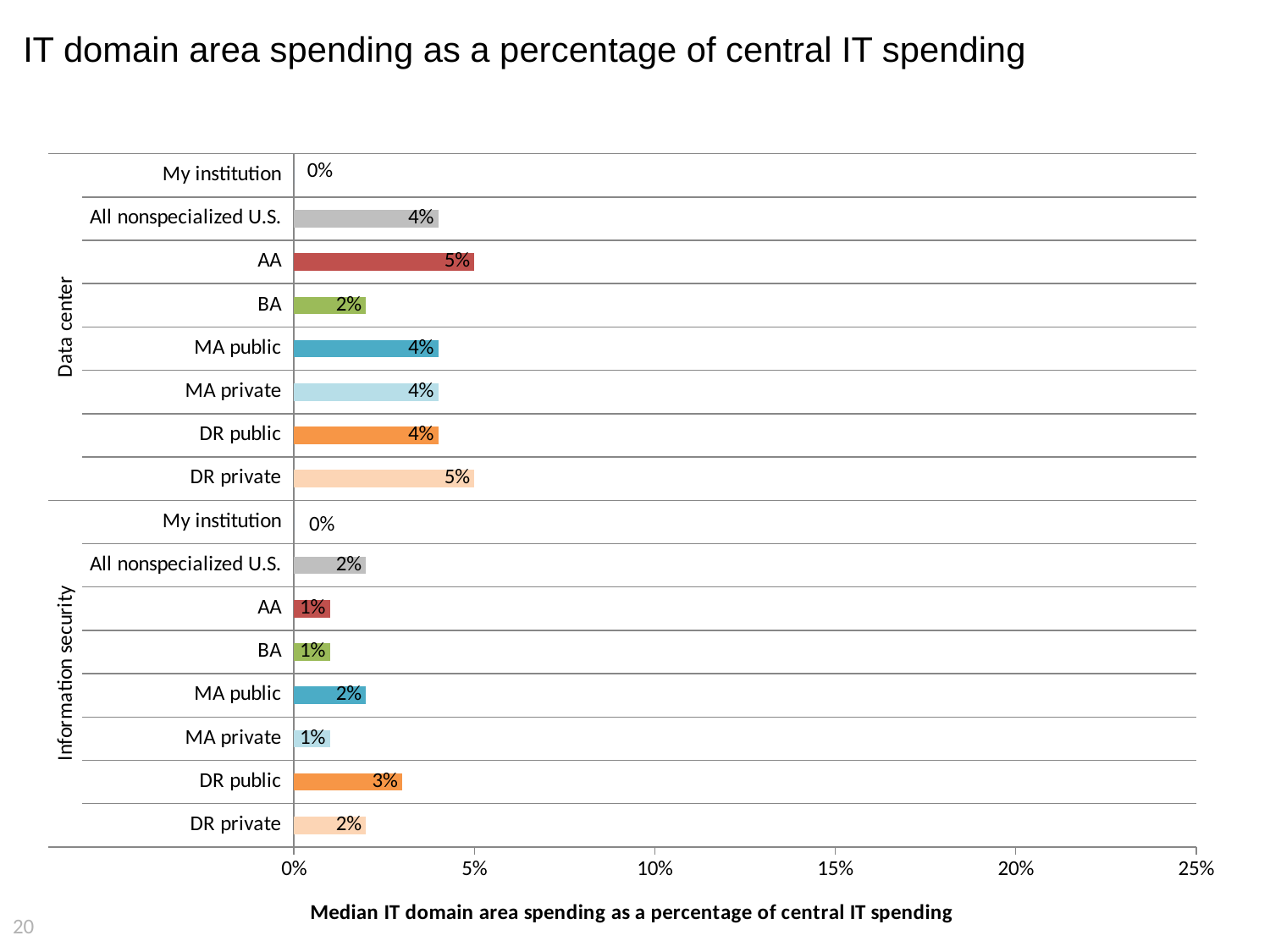
What is the x-axis title of the chart? Median IT domain area spending as a percentage of central IT spending What is the Data center value for AA? 5% What kind of chart is shown on the slide? Bar chart Which category has the lowest value in the Data center group? My institution In the Data center group, which is larger: the value for AA or the value for BA? AA Which category has the highest value in the Information security group? DR public What is the Data center value for BA? 2% Is the Data center value for DR private greater or less than 10%? less How many bars are plotted in the Information security group? 8 What is the difference between the Data center values for AA and BA? 3 percentage points What is the Information security value for DR public? 3% What is the Information security value for MA private? 1%